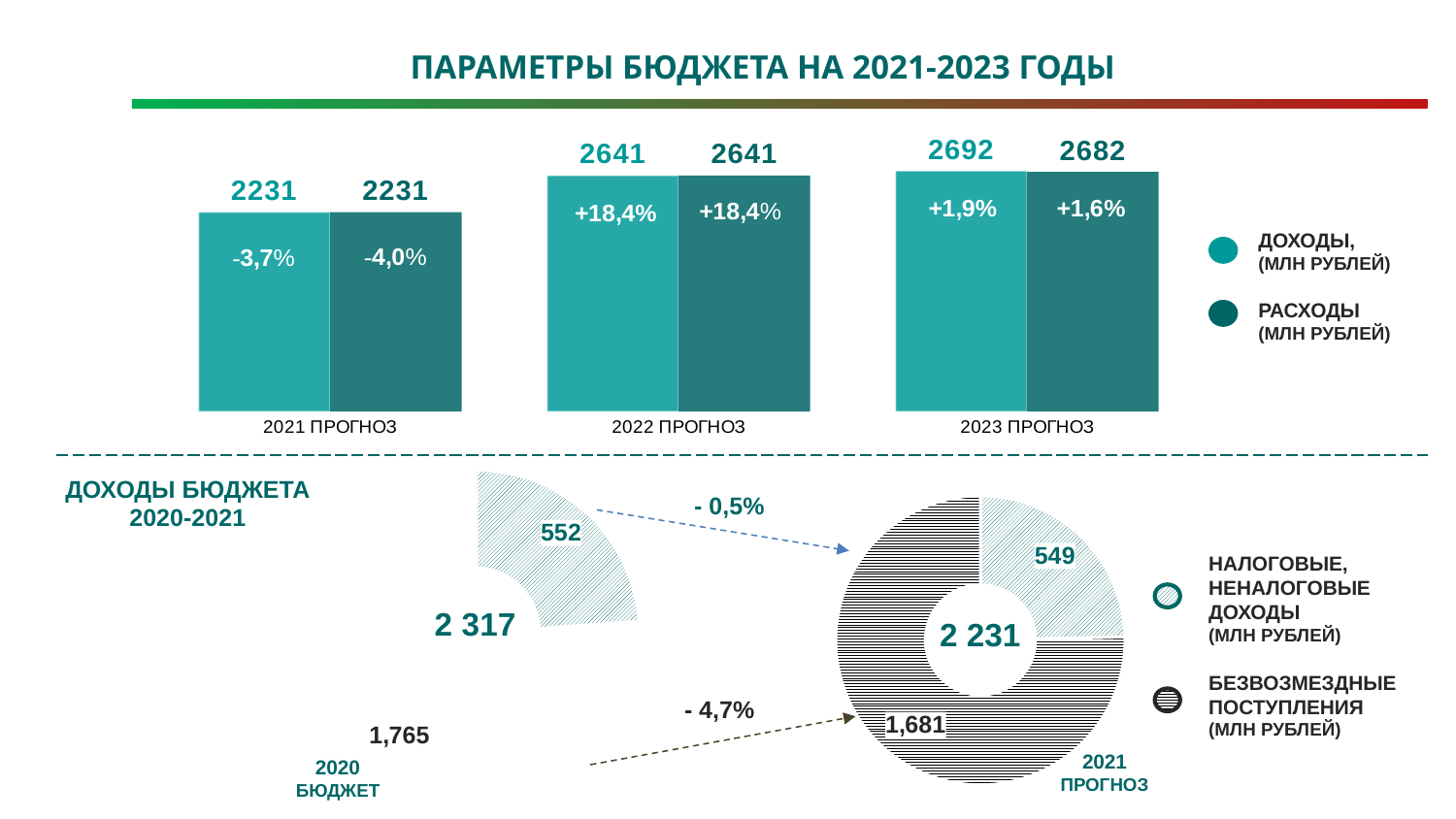
In the top bar chart, how many series does the legend list? 2 In the top bar chart, what is the value of ДОХОДЫ for 2022 ПРОГНОЗ? 2641 In the top bar chart, how many years (categories) are shown? 3 In the top bar chart, which year has the lowest РАСХОДЫ value? 2021 ПРОГНОЗ In the top bar chart, what is the difference between ДОХОДЫ and РАСХОДЫ for 2023 ПРОГНОЗ? 10 In the top bar chart, do the ДОХОДЫ values rise or fall from 2021 ПРОГНОЗ to 2023 ПРОГНОЗ? rise In the top bar chart, which year has the highest ДОХОДЫ value? 2023 ПРОГНОЗ In the top bar chart, what is the value of РАСХОДЫ for 2023 ПРОГНОЗ? 2682 In the 2021 ПРОГНОЗ donut chart at the bottom, what is the value for НАЛОГОВЫЕ, НЕНАЛОГОВЫЕ ДОХОДЫ? 549 What total is shown in the centre of the 2021 ПРОГНОЗ donut chart? 2 231 What kind of chart is the top chart on the slide? bar chart In the 2020 БЮДЖЕТ donut chart at the bottom, what is the value for БЕЗВОЗМЕЗДНЫЕ ПОСТУПЛЕНИЯ? 1,765